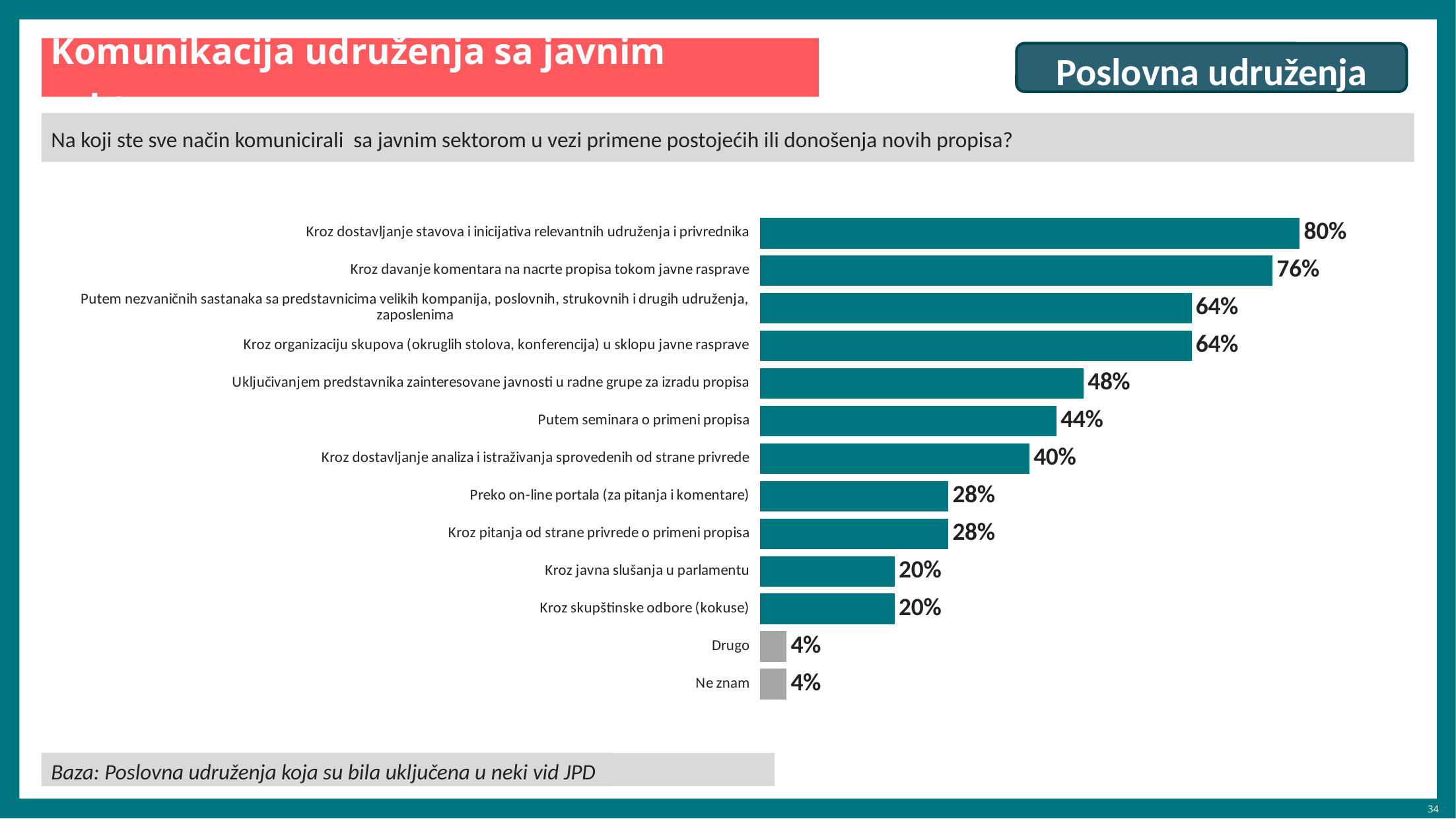
What value is shown for "Putem seminara o primeni propisa"? 44% What value is shown for "Kroz javna slušanja u parlamentu"? 20% What value is shown for "Drugo"? 4% Which is larger: "Kroz dostavljanje analiza i istraživanja sprovedenih od strane privrede" or "Kroz pitanja od strane privrede o primeni propisa"? Kroz dostavljanje analiza i istraživanja sprovedenih od strane privrede Which two categories are shown in grey bars rather than teal? Drugo and Ne znam What is the difference between "Uključivanjem predstavnika zainteresovane javnosti u radne grupe za izradu propisa" and "Preko on-line portala (za pitanja i komentare)"? 20% What is the value of the highest bar? 80% What value is shown for "Kroz davanje komentara na nacrte propisa tokom javne rasprave"? 76% Which category has the highest value? Kroz dostavljanje stavova i inicijativa relevantnih udruženja i privrednika How many categories are shown in the chart? 13 What is the difference between "Kroz dostavljanje stavova i inicijativa relevantnih udruženja i privrednika" and "Kroz davanje komentara na nacrte propisa tokom javne rasprave"? 4% What kind of chart is shown on the slide? Bar chart